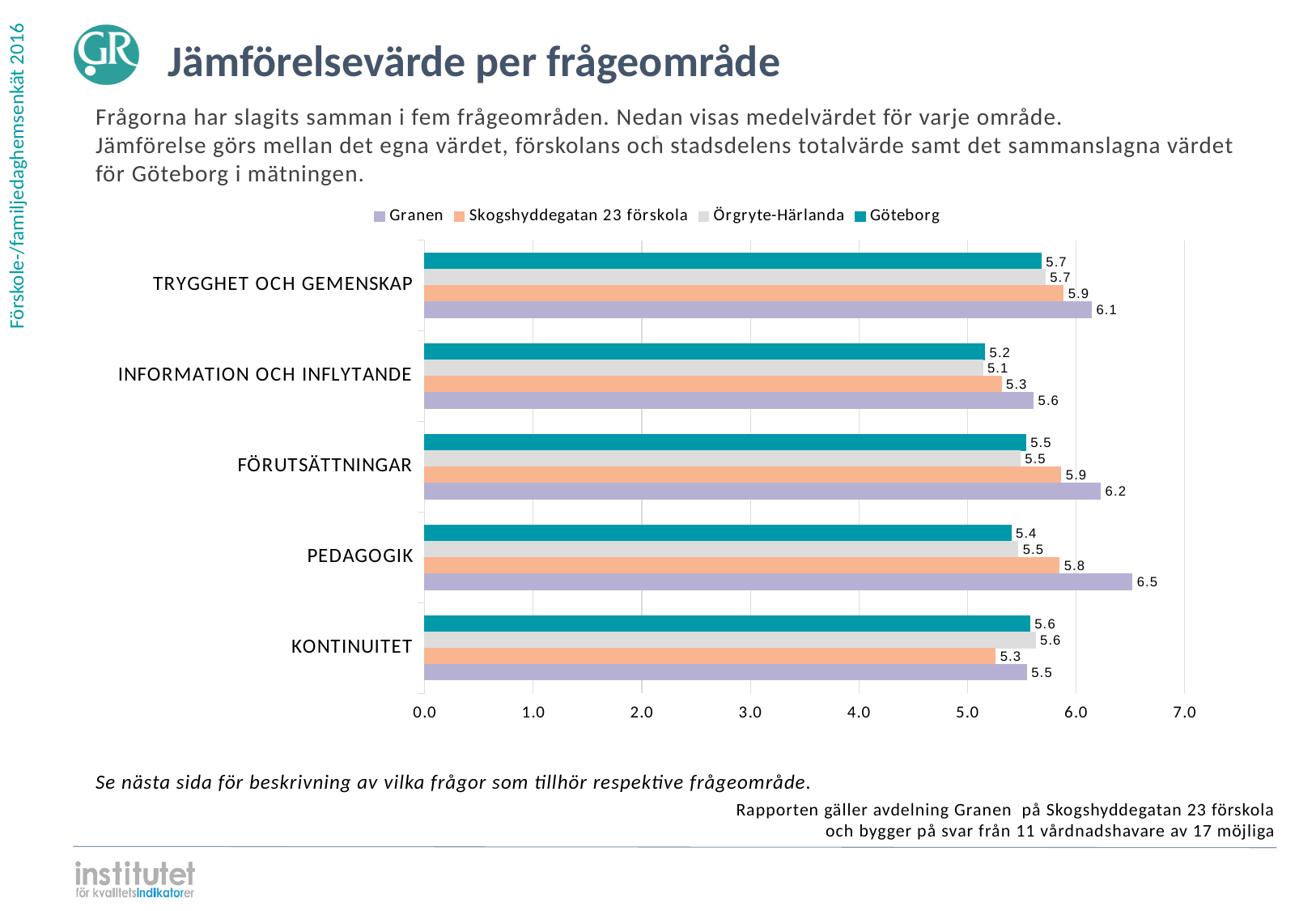
In which category does Granen have its lowest value? KONTINUITET What is the difference between the Granen value and the Göteborg value in the PEDAGOGIK category? 1.1 What is the value for Göteborg in the INFORMATION OCH INFLYTANDE category? 5.2 What is the value for Granen in the PEDAGOGIK category? 6.5 Which is larger in the KONTINUITET category: the value for Granen or the value for Göteborg? Göteborg What kind of chart is shown on the slide? Bar chart What is the title of the slide? Jämförelsevärde per frågeområde How many categories are shown on the chart? 5 How many series does the legend list? 4 What is the value for Skogshyddegatan 23 förskola in the KONTINUITET category? 5.3 In which category does Granen have its highest value? PEDAGOGIK Is the value for Granen in FÖRUTSÄTTNINGAR greater or less than 6.0? greater